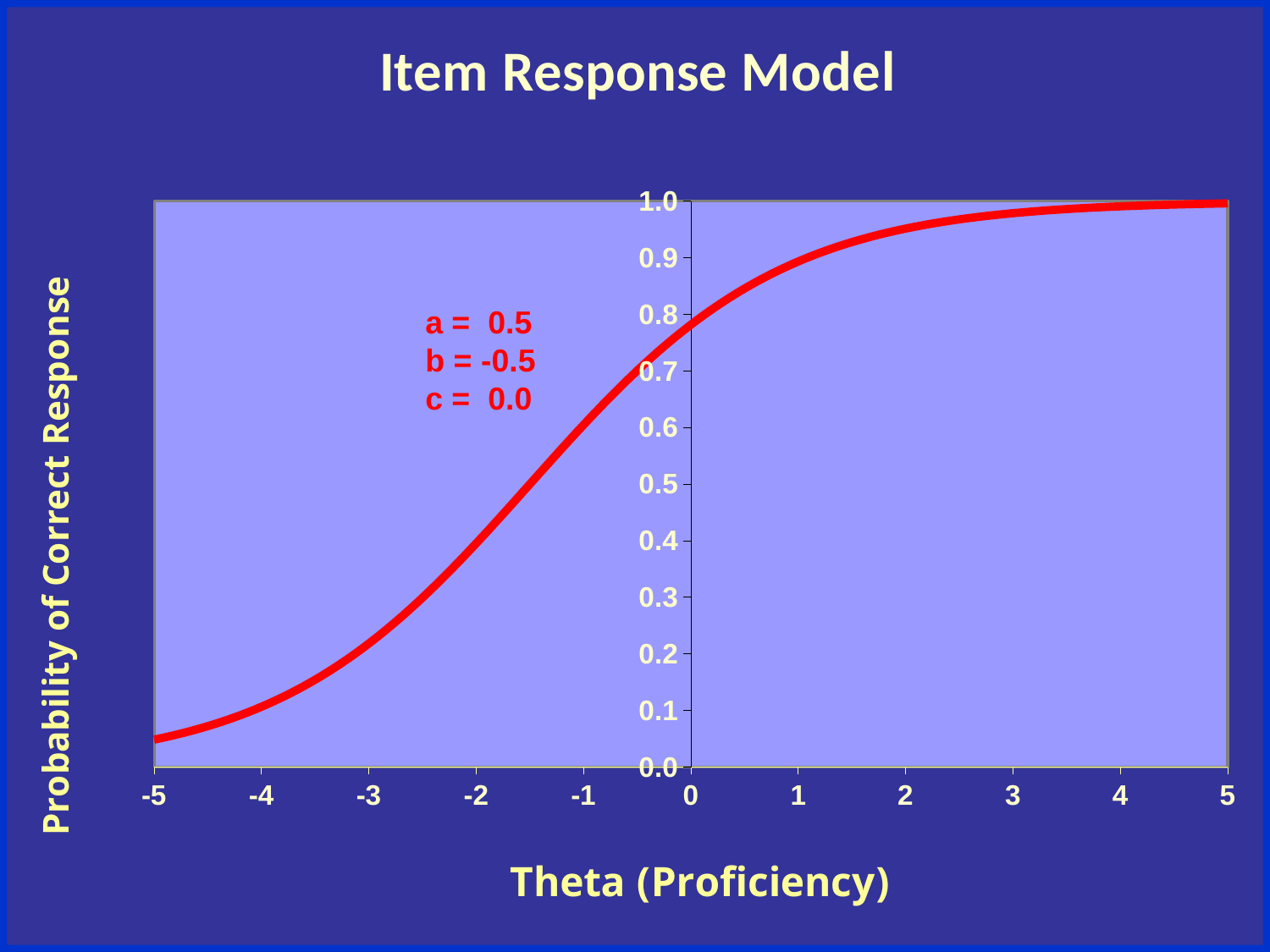
Is the probability of correct response at theta = 2 greater or less than 0.9? greater How many tick marks are labelled on the Theta (Proficiency) axis? 11 What is the title of the chart? Item Response Model Which theta value has the higher probability of correct response, theta = -2 or theta = 2? theta = 2 Is the probability of correct response at theta = 0 greater or less than 0.7? greater Is the probability of correct response at theta = -3 greater or less than 0.5? less What kind of chart is shown on the slide? line chart Does the probability of correct response rise or fall as theta increases from -5 to 5? rise What value of the parameter b is shown on the chart? -0.5